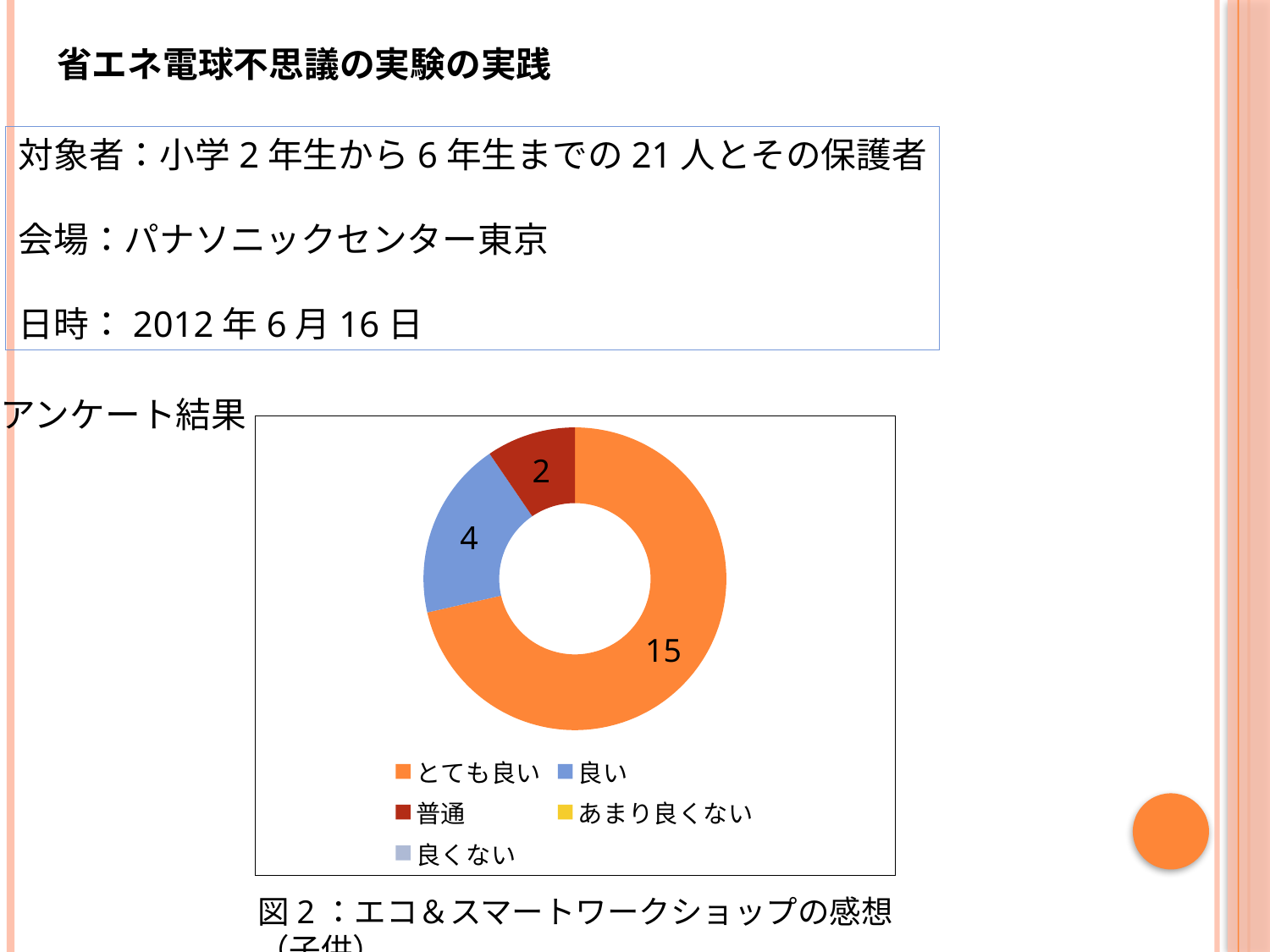
What value is shown for the 普通 slice of the chart? 2 What kind of chart is shown on the slide? Doughnut (pie) chart Which is larger, the 良い slice or the 普通 slice? 良い What value is shown for the 良い slice of the chart? 4 What fraction of the total responses does the とても良い slice represent? 15 out of 21 What is the total of the three labelled slices in the chart? 21 What is the difference between the とても良い value and the 良い value? 11 What colour is the とても良い slice in the chart? Orange How many respondents answered とても良い in the doughnut chart? 15 Which category has the largest slice in the chart? とても良い Which of the labelled slices has the smallest value? 普通 How many entries does the chart legend list? 5